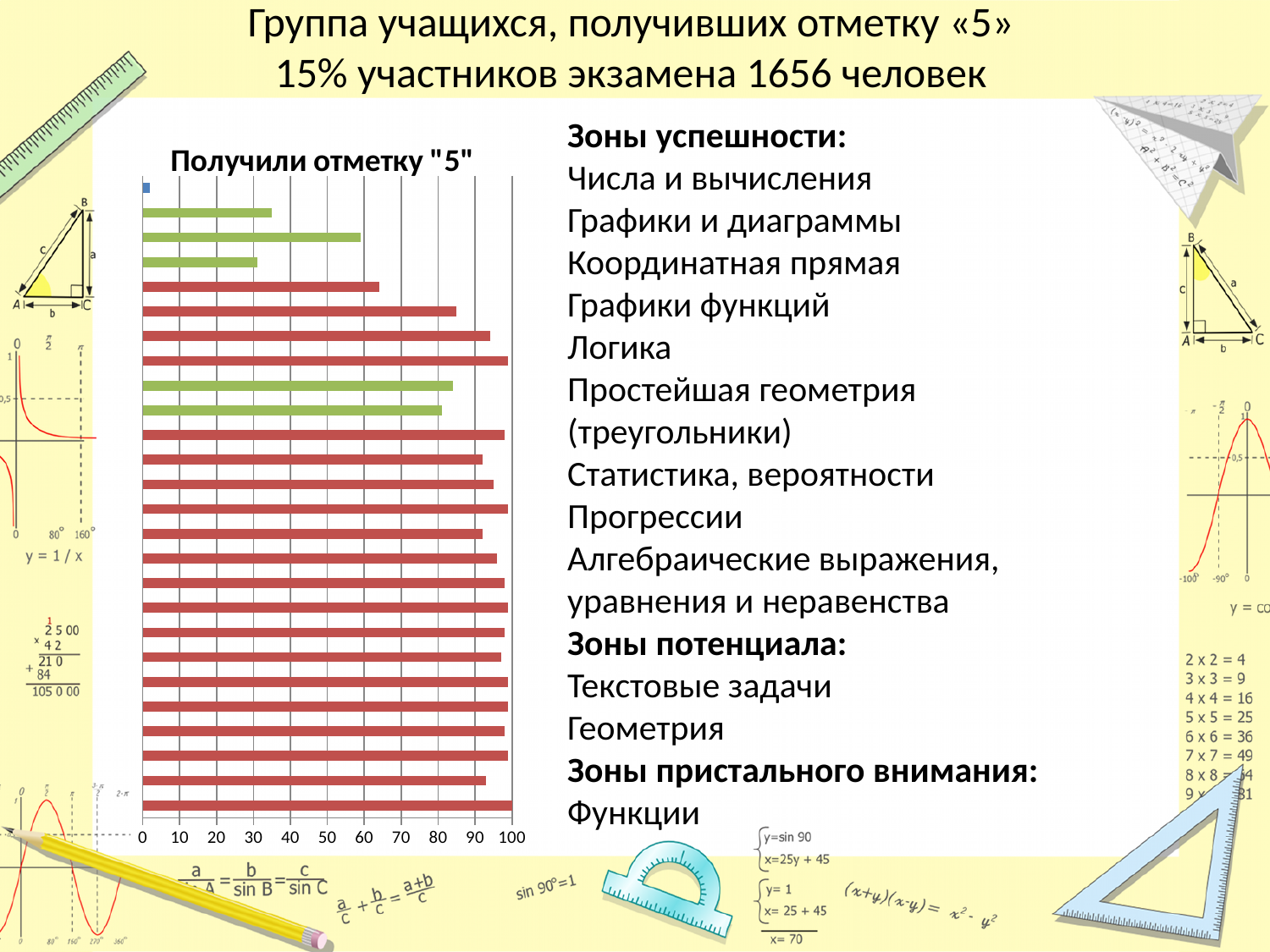
Is the value of the third green bar from the top greater or less than 40? less What is the title of the chart? Получили отметку "5" What is the highest value shown on the chart's horizontal axis? 100 How many green bars are there in the chart? 5 Is the value of the first red bar from the top greater or less than 70? less Which is larger: the second green bar from the top or the third green bar from the top? the second green bar Is the value of the topmost green bar greater or less than 30? greater What kind of chart is shown on the slide? bar chart